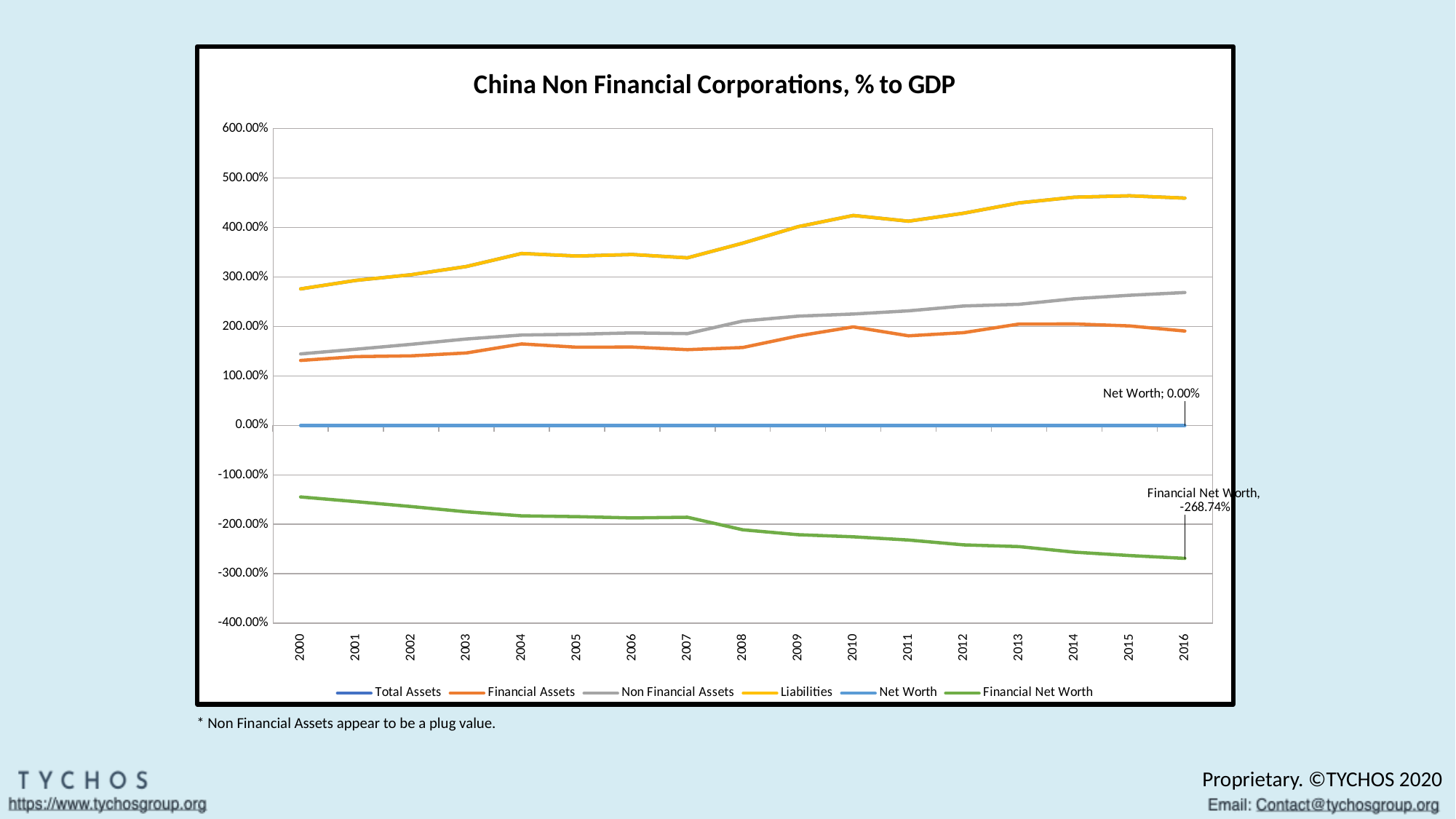
How many series does the legend list? 6 What is the value of Financial Net Worth in 2016? -268.74% Is the value for Non Financial Assets in 2016 greater or less than 200.00%? greater Which series has the lowest value in 2016? Financial Net Worth What is the value of Net Worth in 2016? 0.00% What kind of chart is shown on the slide? line chart Do the Liabilities values generally rise or fall from 2000 to 2016? rise Do the Financial Net Worth values generally rise or fall from 2000 to 2016? fall What is the title of the chart? China Non Financial Corporations, % to GDP Is the value for Liabilities in 2016 greater or less than 400.00%? greater Is the value for Liabilities in 2000 greater or less than 300.00%? less How many years are shown on the x axis? 17